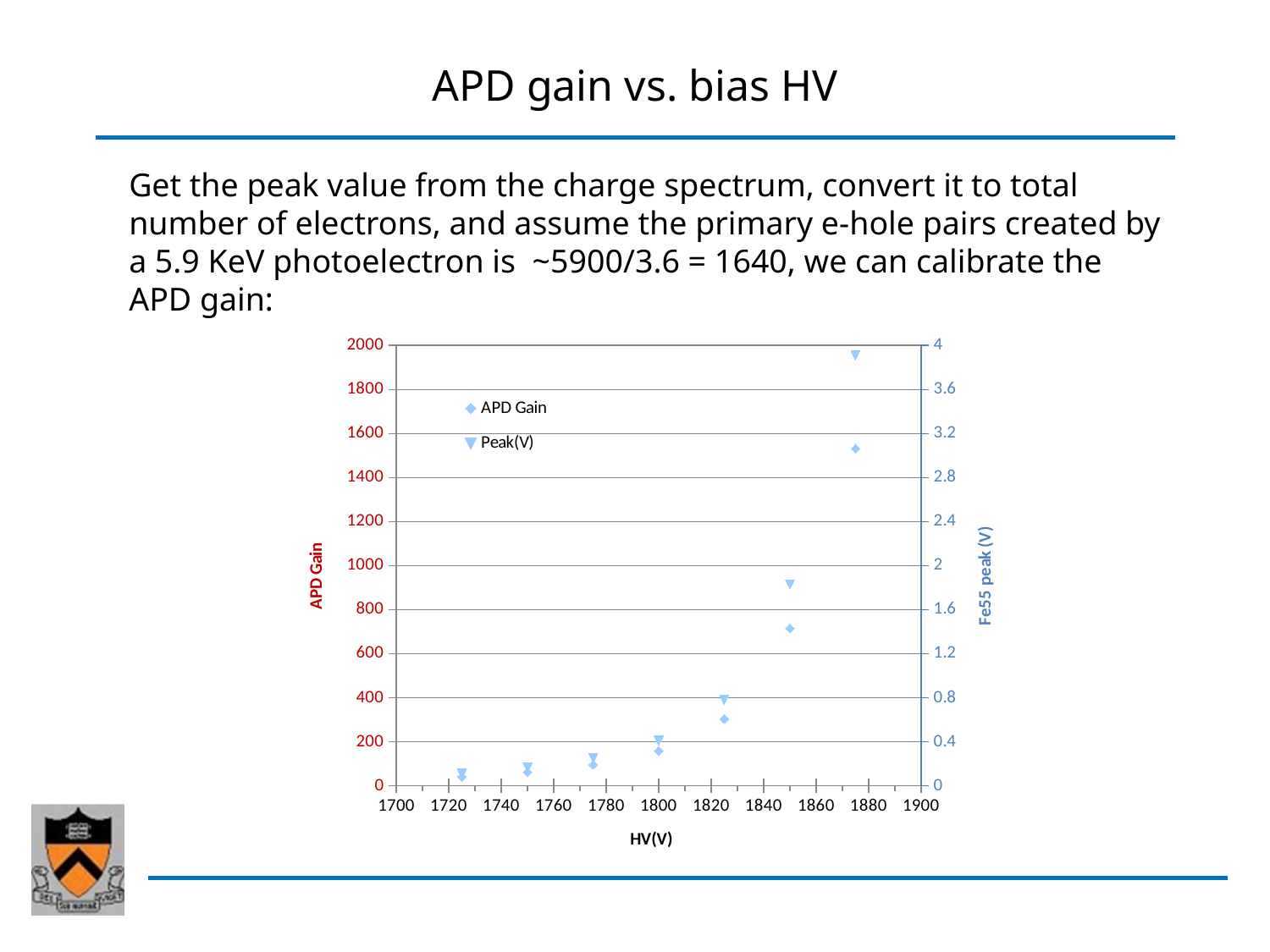
Is the APD Gain at HV 1875 greater or less than 1400? greater Does the APD Gain rise or fall as HV increases along the x axis? rise What kind of chart is shown on the slide? scatter chart How many series does the chart legend list? 2 Which is larger, the APD Gain at HV 1850 or the APD Gain at HV 1825? HV 1850 Is the Peak(V) value at HV 1875 greater or less than 3.6 on the right axis? greater What is the label of the x axis of the chart? HV(V) What are the two series named in the chart legend? APD Gain and Peak(V) How many data points are plotted for the APD Gain series? 7 Is the APD Gain at HV 1850 greater or less than 800? less